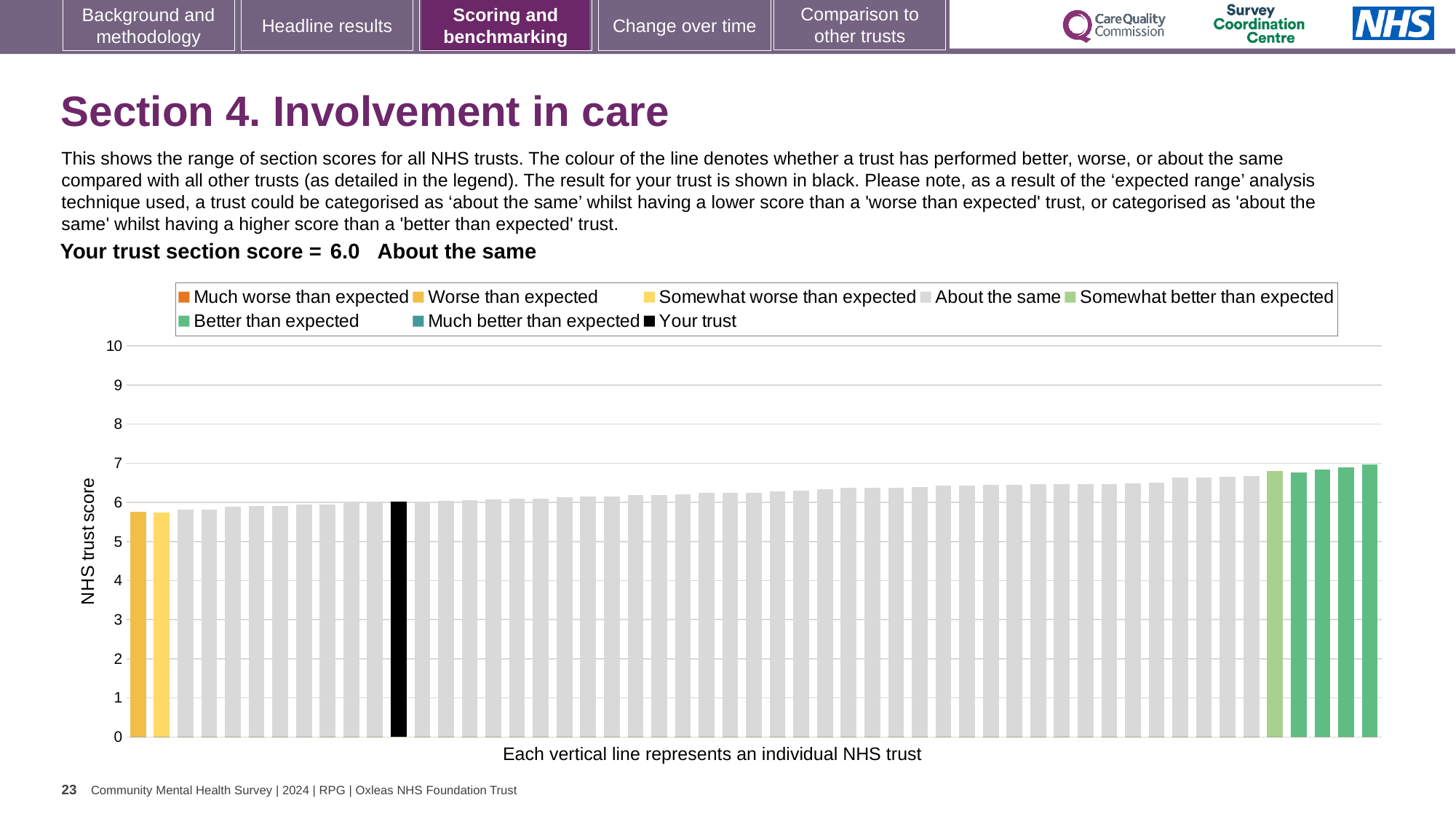
Is the value of the lowest bar greater or less than 5? greater Which category is your trust's section score placed in? About the same What is the highest value shown on the vertical axis? 10 What kind of chart is shown on the slide? bar chart Is the value of the lowest bar greater or less than 6? less How many bars are coloured as 'Better than expected' (dark green)? 4 What is the section score for your trust shown on the slide? 6.0 What colour is the bar representing your trust? black What is the label on the vertical axis of the chart? NHS trust score Do the bar values rise or fall from left to right along the x axis? rise Is the value of the highest bar greater or less than 6? greater How many entries does the chart legend list? 8